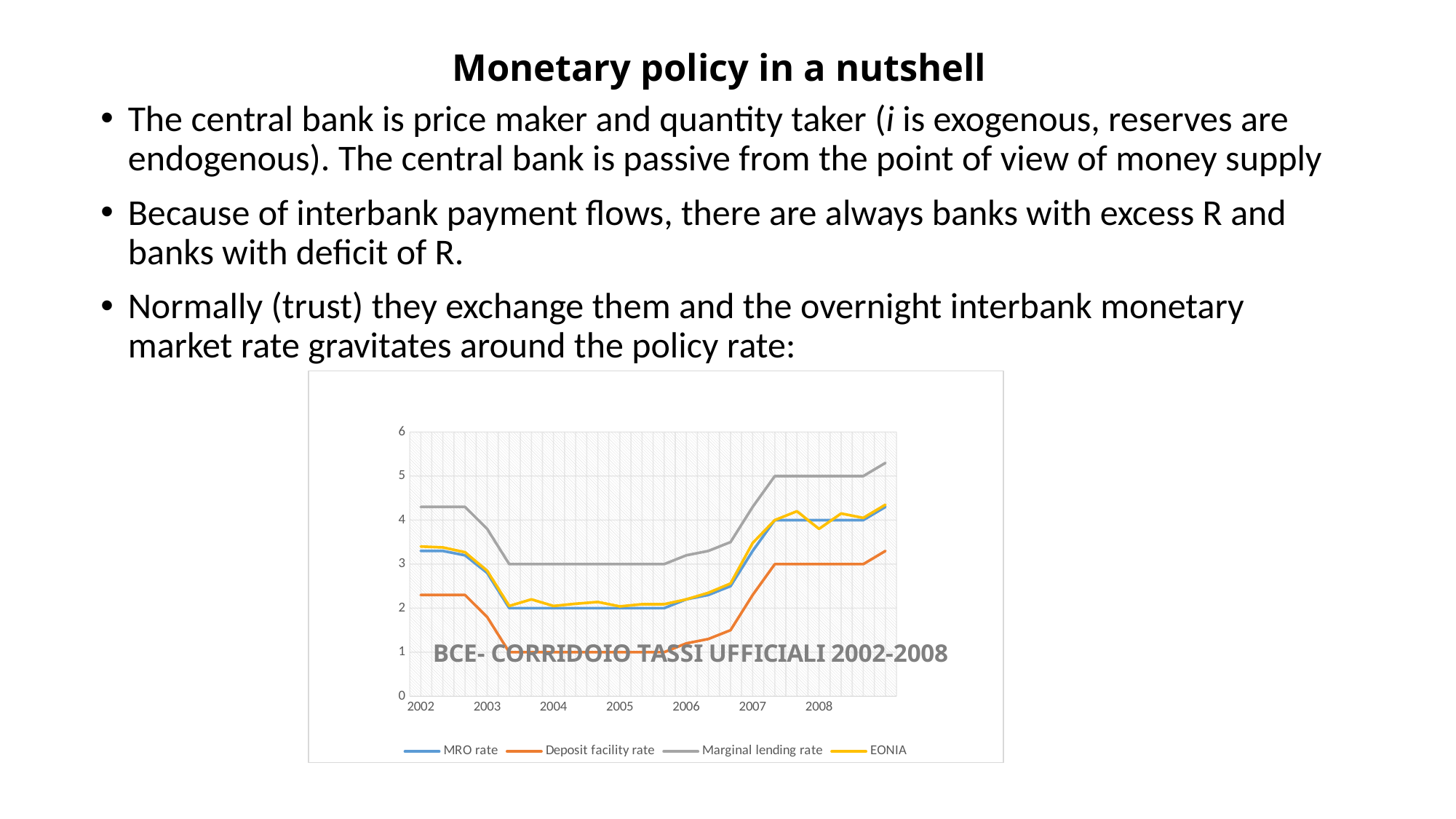
Is the value of the Marginal lending rate in 2002 greater or less than 4? greater Which series has the lowest values across the whole period? Deposit facility rate What is the title of the chart? BCE- CORRIDOIO TASSI UFFICIALI 2002-2008 Does the Marginal lending rate rise or fall between 2004 and 2008? Rise Is the value of the MRO rate in 2005 greater or less than 3? less In 2006, which is larger: the Marginal lending rate or the Deposit facility rate? Marginal lending rate Which series has the highest values across the whole period? Marginal lending rate What kind of chart is shown on the slide? Line chart Is the value of EONIA in 2008 greater or less than 3? greater Which series is plotted in orange? Deposit facility rate How many series does the chart legend list? 4